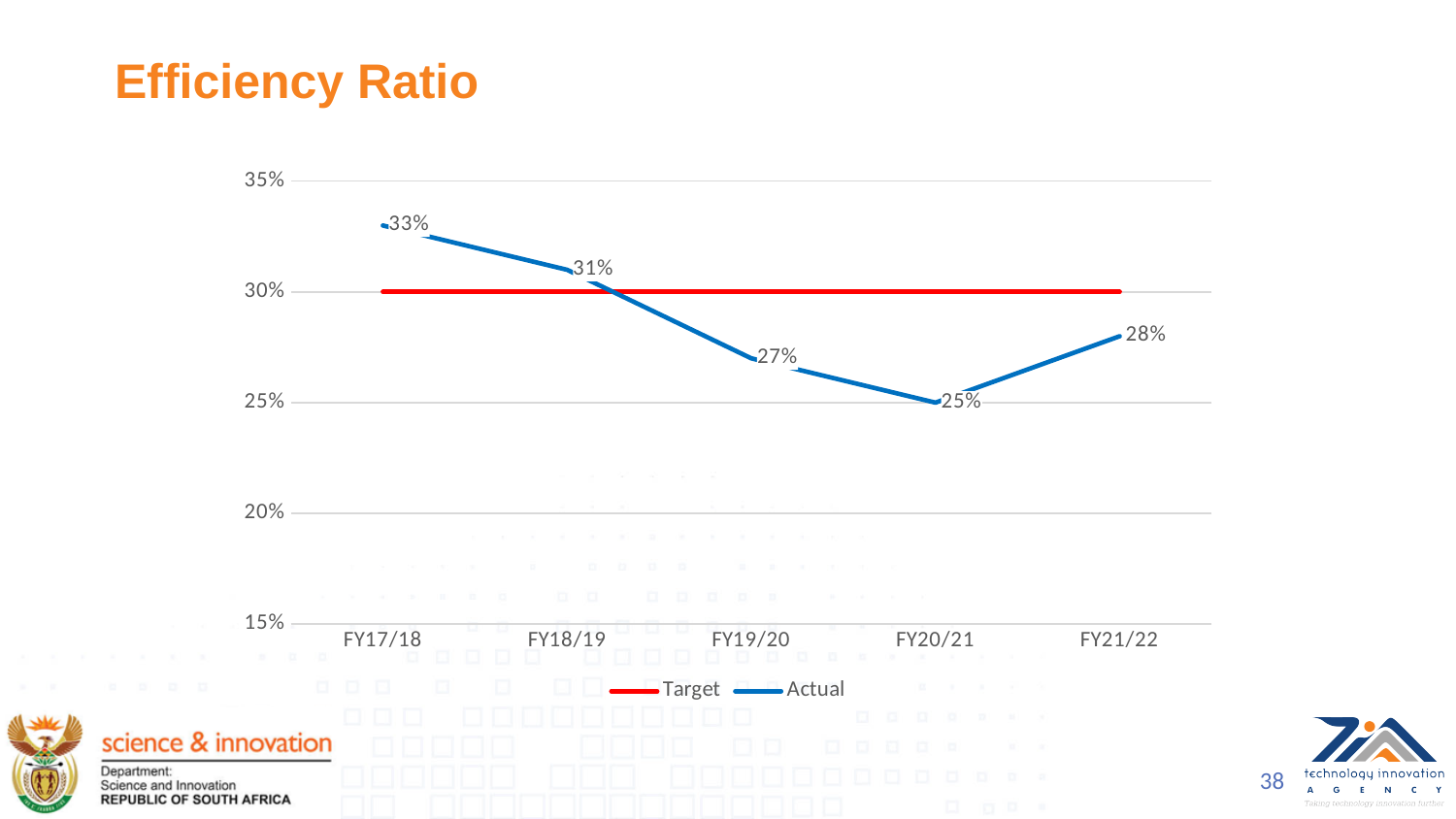
What kind of chart is shown on the slide? line chart What is the Actual efficiency ratio for FY21/22? 28% In which fiscal year is the Actual efficiency ratio lowest? FY20/21 How many series does the legend list? 2 What is the difference between the Actual efficiency ratio in FY17/18 and FY20/21? 8% Does the Actual efficiency ratio rise or fall from FY17/18 to FY20/21? fall Which is larger, the Actual efficiency ratio in FY18/19 or in FY21/22? FY18/19 What is the Actual efficiency ratio for FY17/18? 33% Is the Actual efficiency ratio for FY19/20 greater or less than 30%? less How many fiscal years are shown on the x axis? 5 In which fiscal year is the Actual efficiency ratio highest? FY17/18 What is the Actual efficiency ratio for FY19/20? 27%